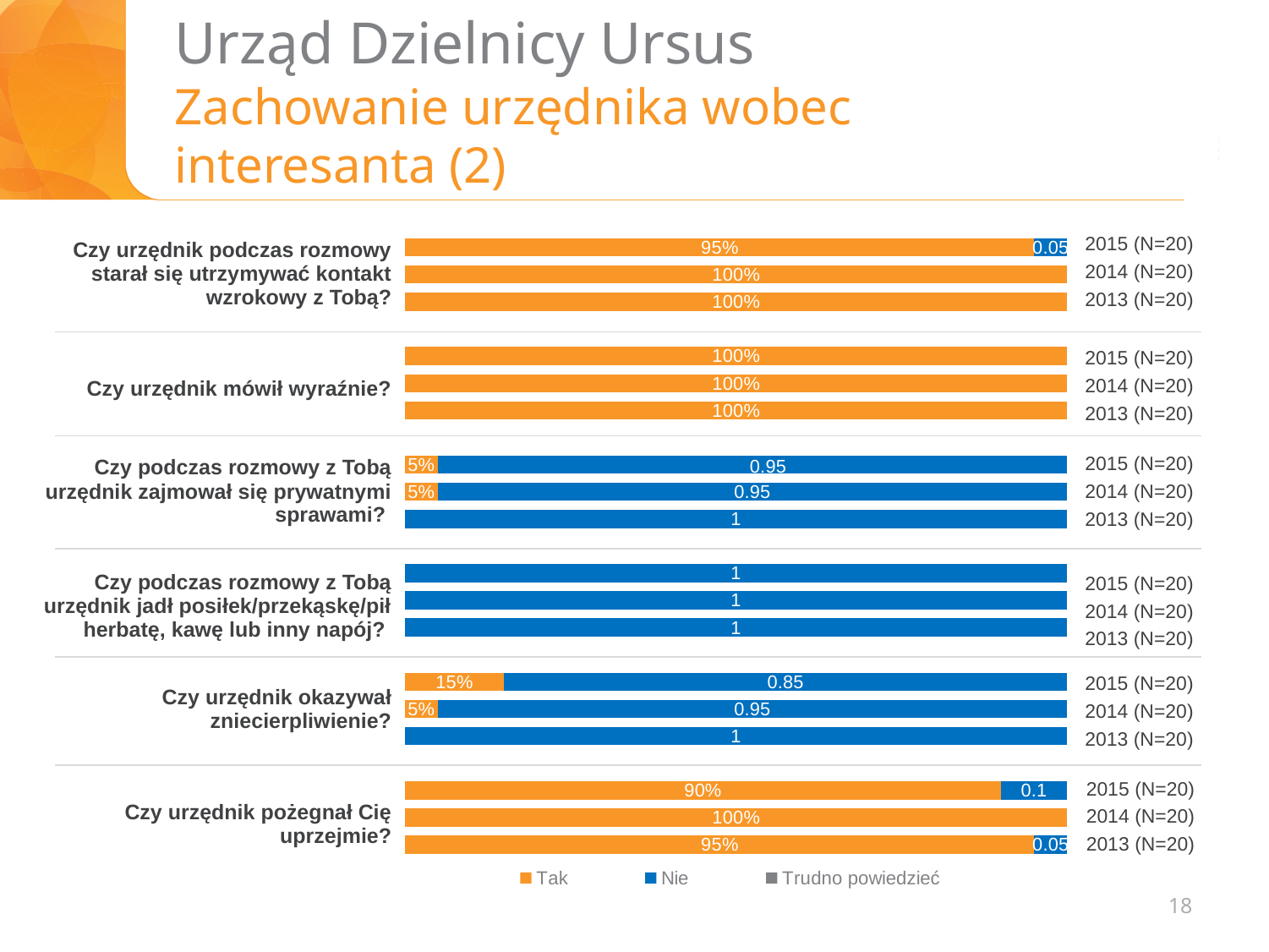
What is the 'Nie' value for 2015 for the question 'Czy urzędnik podczas rozmowy starał się utrzymywać kontakt wzrokowy z Tobą?' 0.05 What is the 'Tak' value for 2015 for the question 'Czy urzędnik pożegnał Cię uprzejmie?' 90% How many series does the legend list? 3 What is the 'Nie' value for 2015 for the question 'Czy urzędnik okazywał zniecierpliwienie?' 0.85 What are the three legend entries? Tak, Nie, Trudno powiedzieć What is the 'Tak' value for 2015 for the question 'Czy urzędnik okazywał zniecierpliwienie?' 15% How many survey questions are shown on the chart? 6 What kind of chart is shown on the slide? Stacked bar chart For the question 'Czy urzędnik okazywał zniecierpliwienie?', is the 'Tak' value larger in 2015 or in 2014? 2015 What is the 'Tak' value for 2015 for the question 'Czy urzędnik podczas rozmowy starał się utrzymywać kontakt wzrokowy z Tobą?' 95% For the question 'Czy urzędnik pożegnał Cię uprzejmie?', which year has the highest 'Tak' value? 2014 What is the sample size (N) shown for each year? N=20